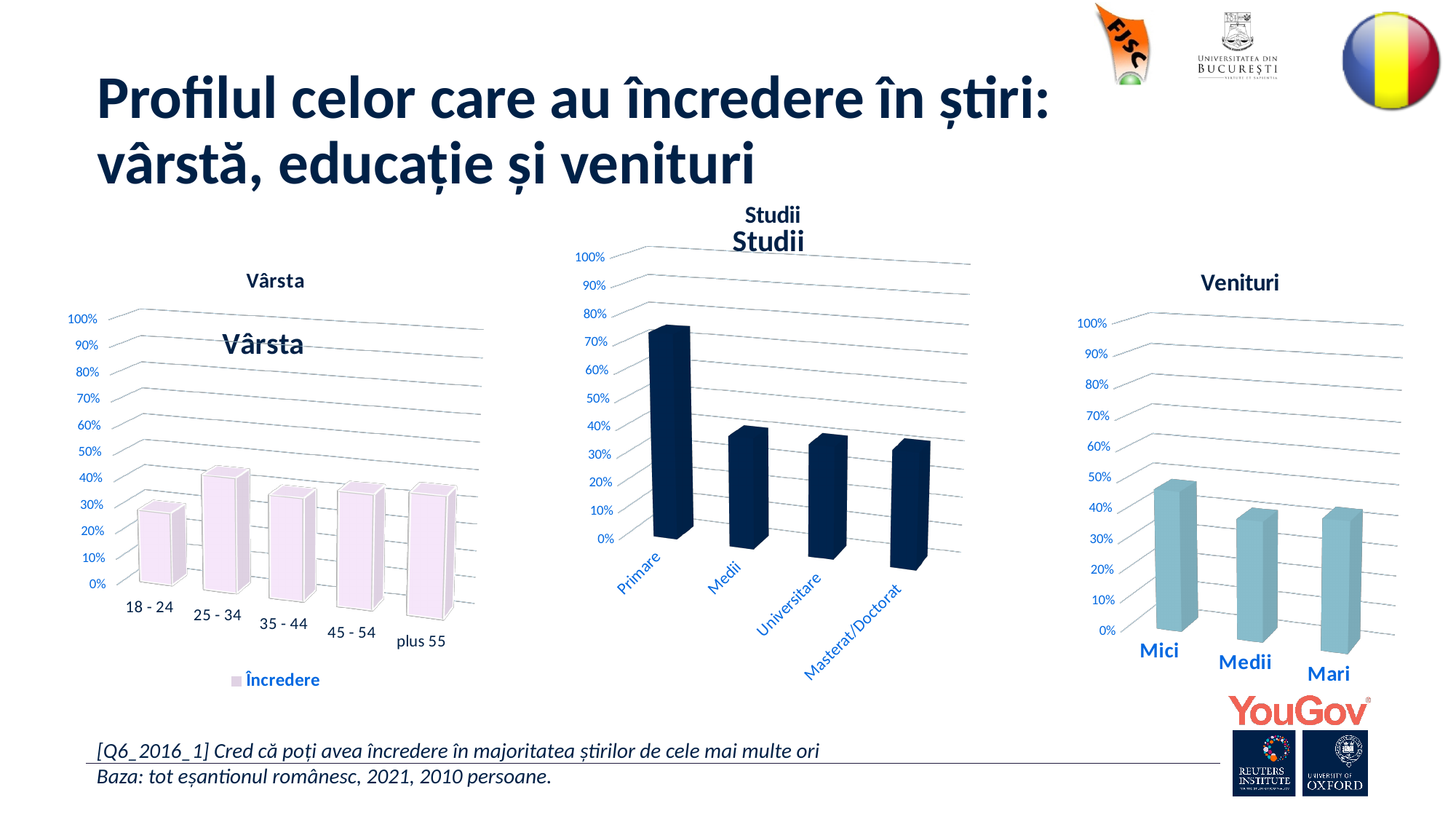
In the Venituri chart, which income category has the highest bar? Mici In the Venituri chart, is the value for Mari greater or less than 60%? less In the Studii chart, which education level has the highest bar? Primare What kind of chart is the Venituri chart? bar chart In the Vârsta chart, is the value for 18 - 24 greater or less than 50%? less In the Studii chart, how many education categories are shown? 4 In the Vârsta chart, which age group has the lowest bar? 18 - 24 In the Vârsta chart, how many series does the legend list? 1 In the Studii chart, is the value for Medii greater or less than 50%? less In the Vârsta chart, how many age groups are shown on the x axis? 5